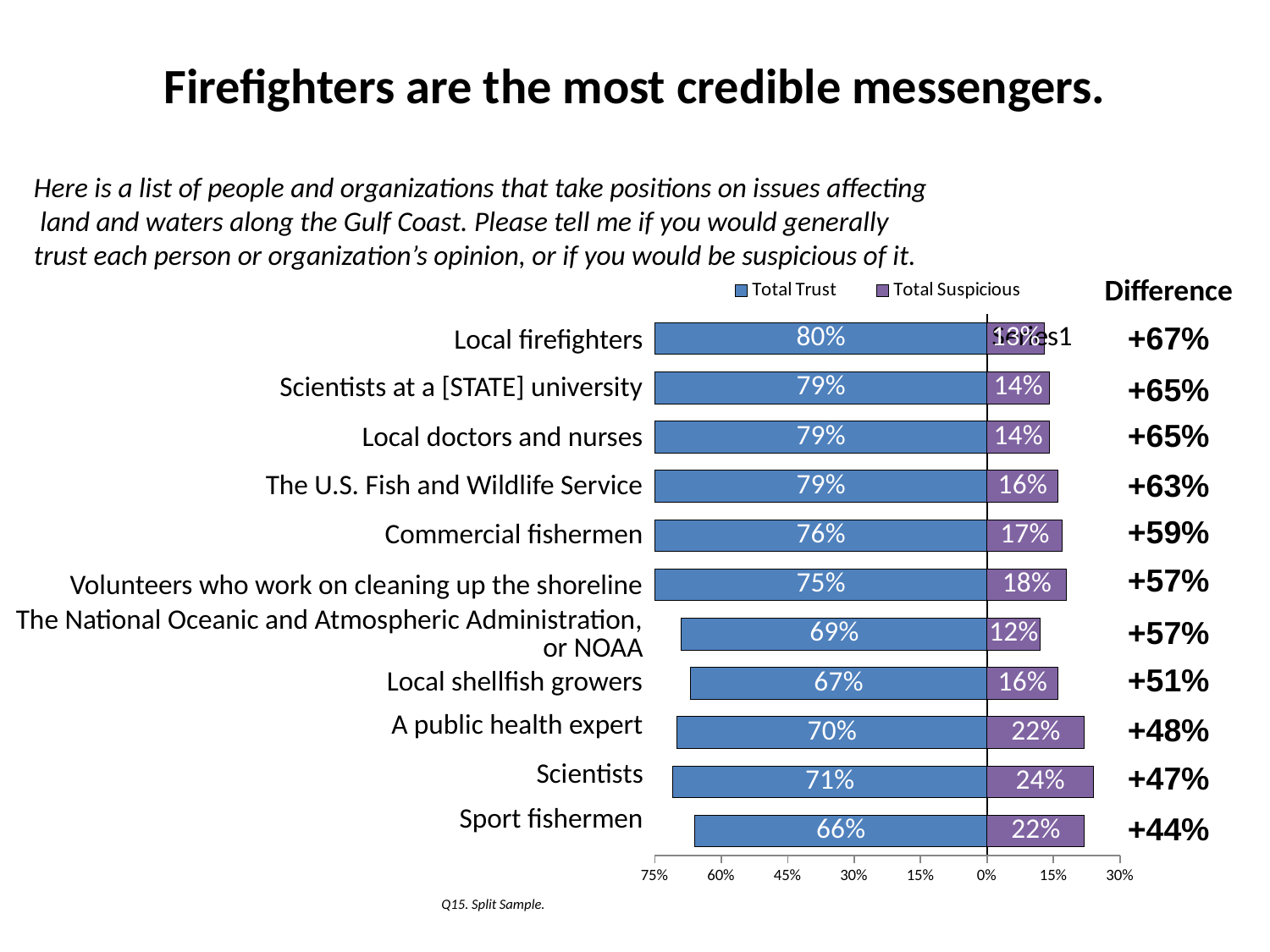
What is the difference between the Total Trust values for Local firefighters and Sport fishermen? 14% What is the Total Suspicious value for Scientists? 24% What kind of chart is shown on the slide? bar chart Which category has the highest Total Trust value? Local firefighters Which is larger, the Total Suspicious value for A public health expert or for Local shellfish growers? A public health expert How many series does the legend list? 2 How many categories (people or organizations) are plotted in the chart? 11 What is the Total Suspicious value for The National Oceanic and Atmospheric Administration, or NOAA? 12% What is the Total Trust value for Sport fishermen? 66% Which category has the lowest Total Trust value? Sport fishermen What is the Total Trust value for Local firefighters? 80% Which category has the highest Total Suspicious value? Scientists